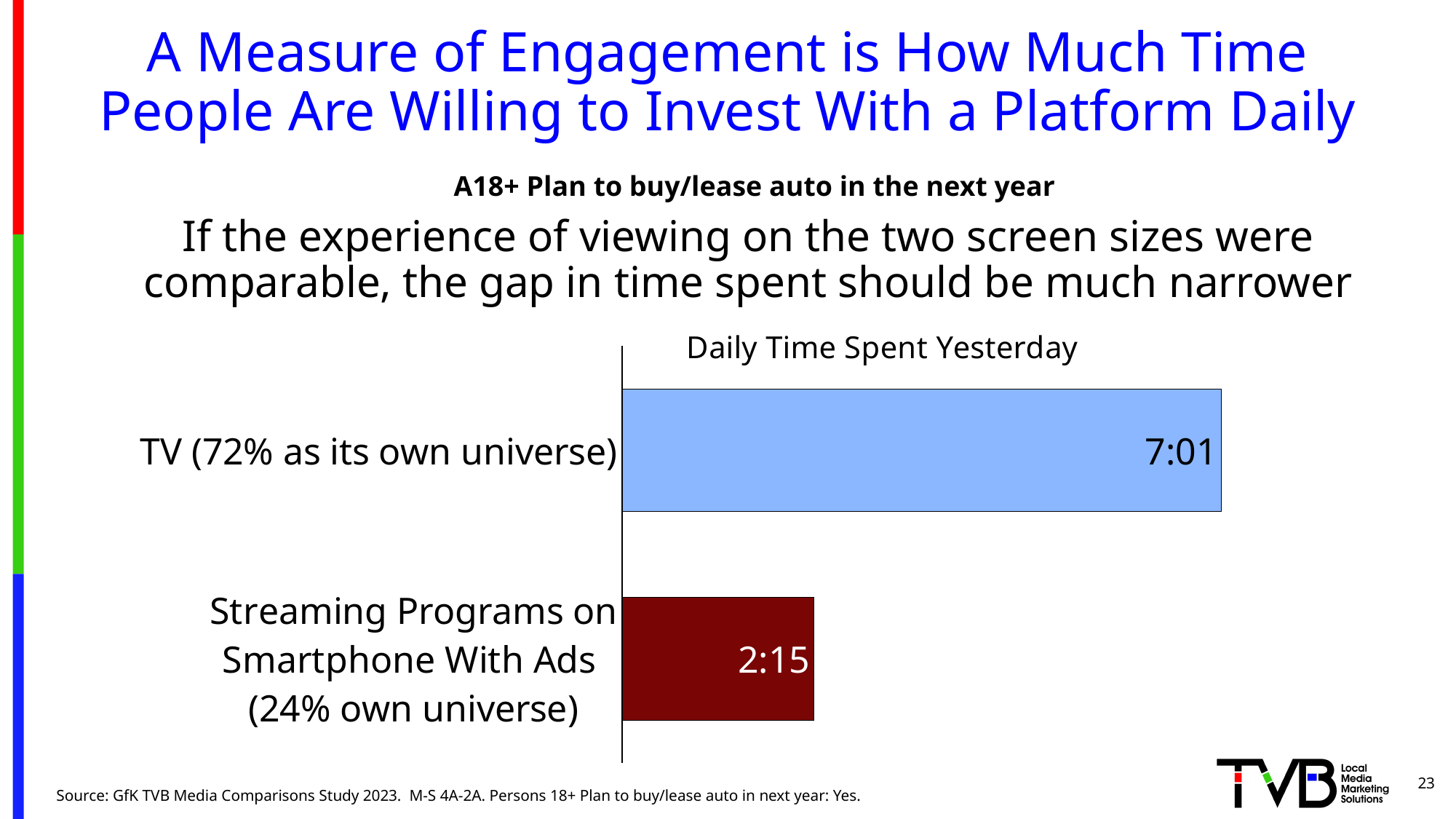
How many categories are shown in the chart? 2 What kind of chart is shown on the slide? Bar chart How much more daily time was spent on TV than on Streaming Programs on Smartphone With Ads? 4:46 What colour is the bar for Streaming Programs on Smartphone With Ads? Dark red Which category has the highest daily time spent yesterday? TV (72% as its own universe) What is the daily time spent yesterday for Streaming Programs on Smartphone With Ads (24% own universe)? 2:15 What is the daily time spent yesterday for TV (72% as its own universe)? 7:01 What is the title of the chart? Daily Time Spent Yesterday Which has a larger daily time spent yesterday: TV or Streaming Programs on Smartphone With Ads? TV Which category has the lowest daily time spent yesterday? Streaming Programs on Smartphone With Ads (24% own universe)